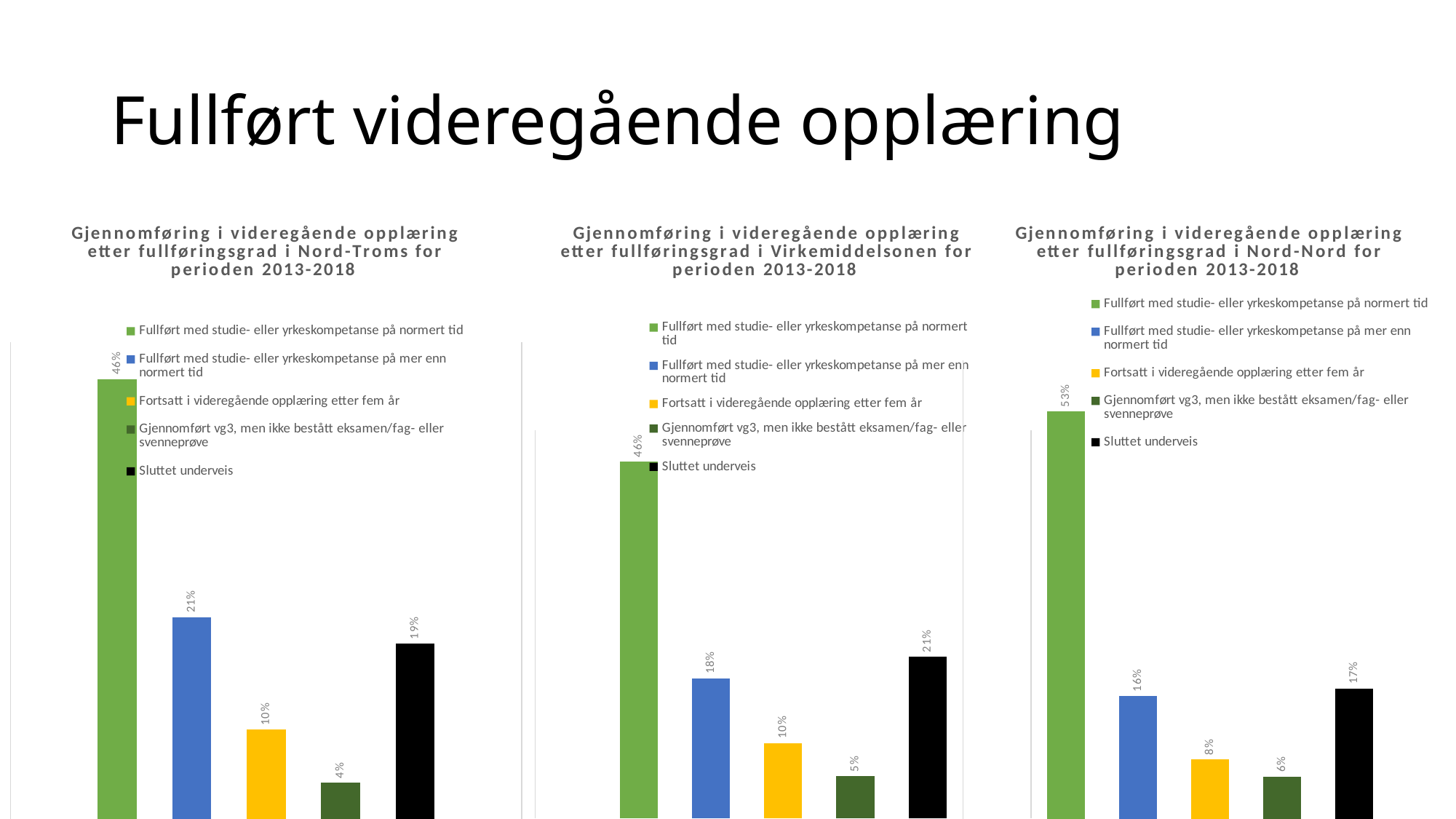
In the Nord-Nord chart, which category has the highest value? Fullført med studie- eller yrkeskompetanse på normert tid In the Nord-Troms chart, what is the value for 'Fullført med studie- eller yrkeskompetanse på normert tid'? 46% How many entries does the legend of the Virkemiddelsonen chart list? 5 How many charts are shown on the slide? 3 In the Virkemiddelsonen chart, what is the value for 'Fortsatt i videregående opplæring etter fem år'? 10% In the Nord-Nord chart, what colour is the bar for 'Sluttet underveis'? Black How many bars are plotted in the Nord-Nord chart? 5 In the Virkemiddelsonen chart, what is the difference between 'Sluttet underveis' and 'Fullført med studie- eller yrkeskompetanse på mer enn normert tid'? 3% In the Nord-Troms chart, which is larger: 'Fullført med studie- eller yrkeskompetanse på mer enn normert tid' or 'Sluttet underveis'? Fullført med studie- eller yrkeskompetanse på mer enn normert tid In the Nord-Troms chart, which category has the lowest value? Gjennomført vg3, men ikke bestått eksamen/fag- eller svenneprøve What type of chart is the Nord-Troms chart? Bar chart In the Nord-Nord chart, what is the value for 'Sluttet underveis'? 17%